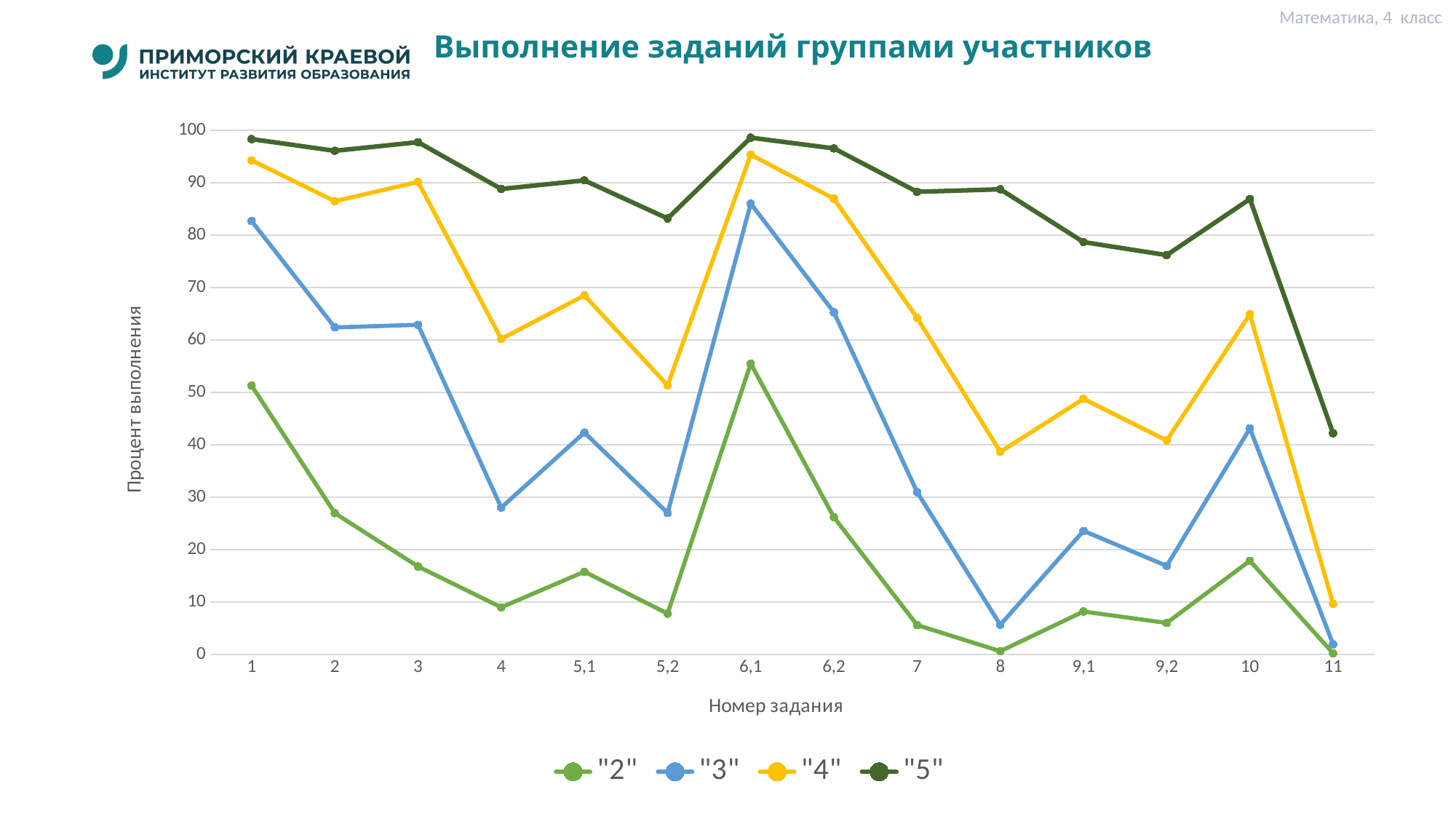
At task 10, which series has the larger value, "4" or "3"? "4" For which task number does series "5" have its lowest value? 11 Is the value for series "3" at task 4 greater or less than 30? less What is the title of the y axis? Процент выполнения What kind of chart is shown on the slide? Line chart How many task numbers are shown along the x axis? 14 For which task number does series "3" have its lowest value? 11 Is the value for series "4" at task 8 greater or less than 40? less Does the value for series "5" rise or fall from task 10 to task 11? Falls Is the value for series "5" at task 11 greater or less than 40? greater For which task number does series "3" have its highest value? 6,1 How many series does the legend list? 4